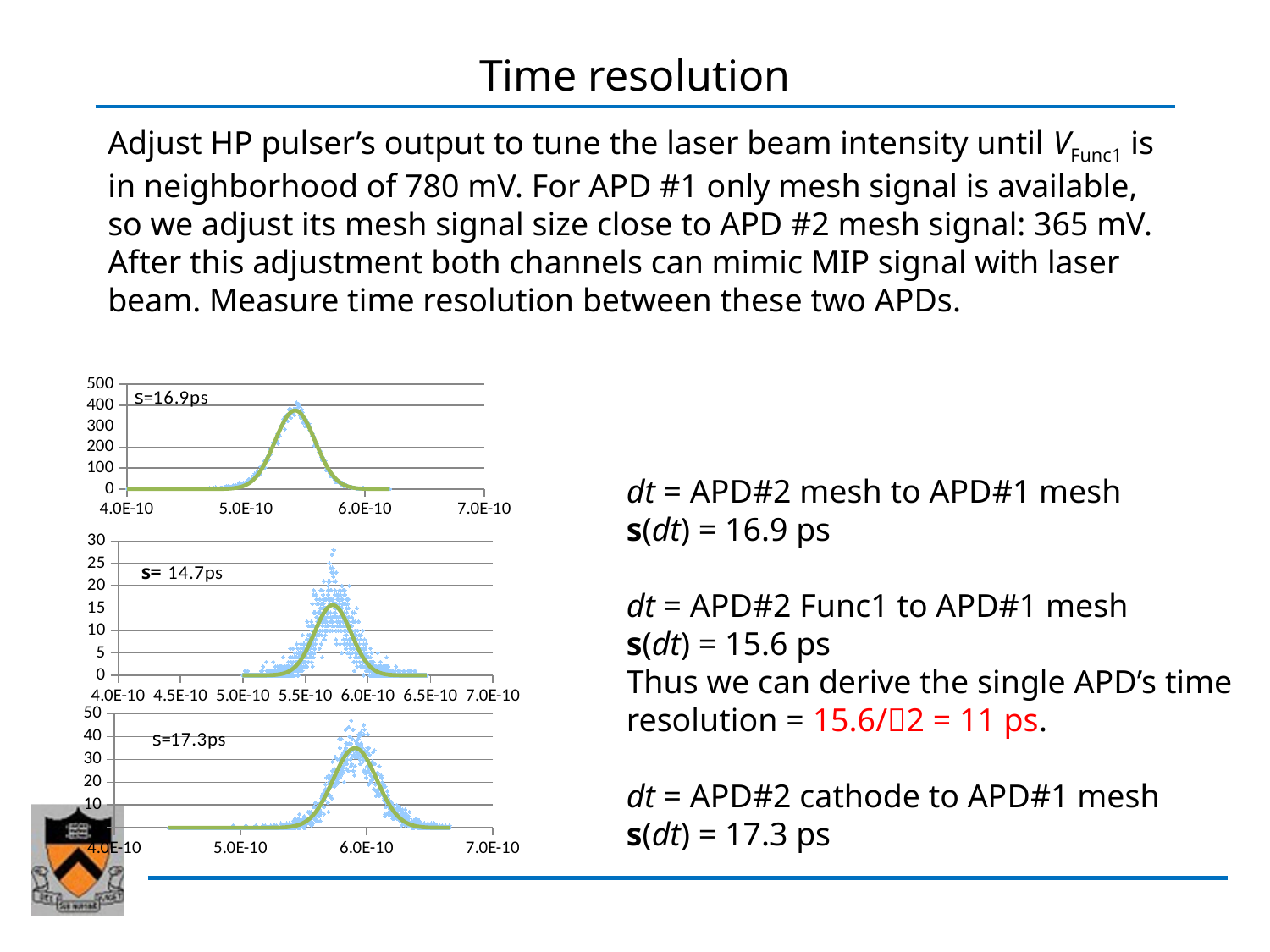
In the top chart, is the peak of the fitted curve greater or less than 300? greater In the bottom chart, does the fitted curve rise or fall between 6.0E-10 and 6.5E-10 on the x axis? fall In the top chart, is the peak of the fitted curve greater or less than 500? less What kind of chart is the top chart on the left of the slide? scatter plot In the middle chart, what value of s is annotated on the plot? s= 14.7ps In the top chart, what value of s is annotated on the plot? s=16.9ps What is the maximum value shown on the y axis of the middle chart? 30 In the middle chart, is the peak of the fitted curve greater or less than 20? less Which chart has the higher peak value: the top chart or the bottom chart? the top chart How many charts are shown on the slide? 3